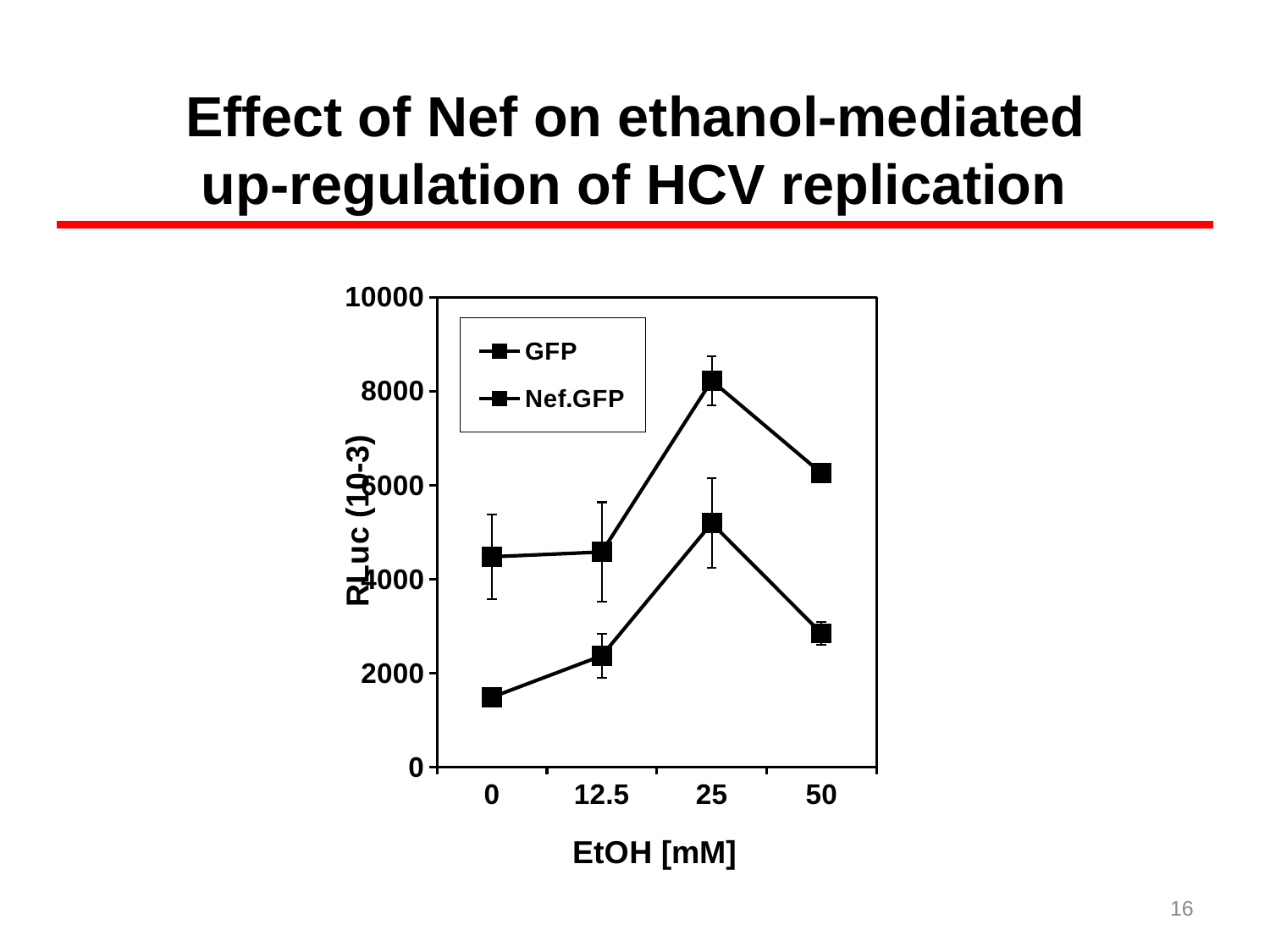
Is the value of the lower line at 50 mM EtOH greater or less than 4000? less How many EtOH concentrations are plotted along the x axis? 4 Is the value of the upper line at 25 mM EtOH greater or less than 6000? greater What is the x-axis title of the chart? EtOH [mM] How many series does the legend list? 2 At which EtOH concentration does the upper line reach its highest value? 25 Between 25 and 50 mM EtOH, does the upper line rise or fall? fall Is the value of the lower line at 25 mM EtOH greater or less than 4000? greater What are the two series named in the legend? GFP and Nef.GFP What kind of chart is shown on the slide? line chart At which EtOH concentration is the lower line at its lowest value? 0